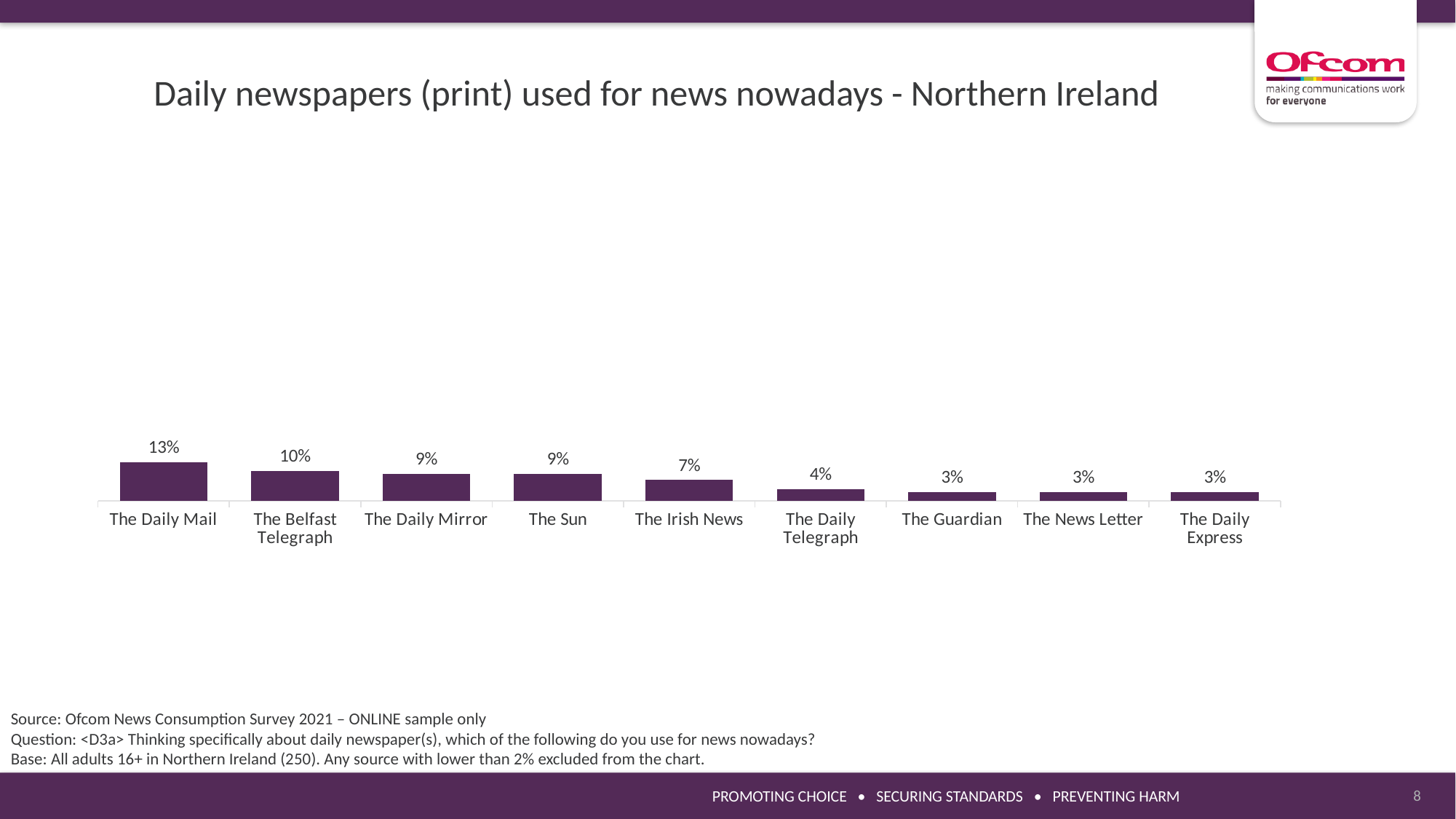
What is the title of the chart? Daily newspapers (print) used for news nowadays - Northern Ireland What kind of chart is shown on the slide? Bar chart What is the value shown for The Belfast Telegraph? 10% What percentage of adults in Northern Ireland use The Daily Mail for news nowadays? 13% Which daily newspaper has the highest value on the chart? The Daily Mail Which has a larger value, The Daily Mirror or The Irish News? The Daily Mirror Do the values rise or fall moving from left to right across the chart? Fall What is the value shown for The Daily Telegraph? 4% How many newspapers are shown on the chart? 9 What is the difference between the values for The Sun and The Guardian? 6% What is the difference between the values for The Daily Mail and The Belfast Telegraph? 3% What is the value shown for The Irish News? 7%